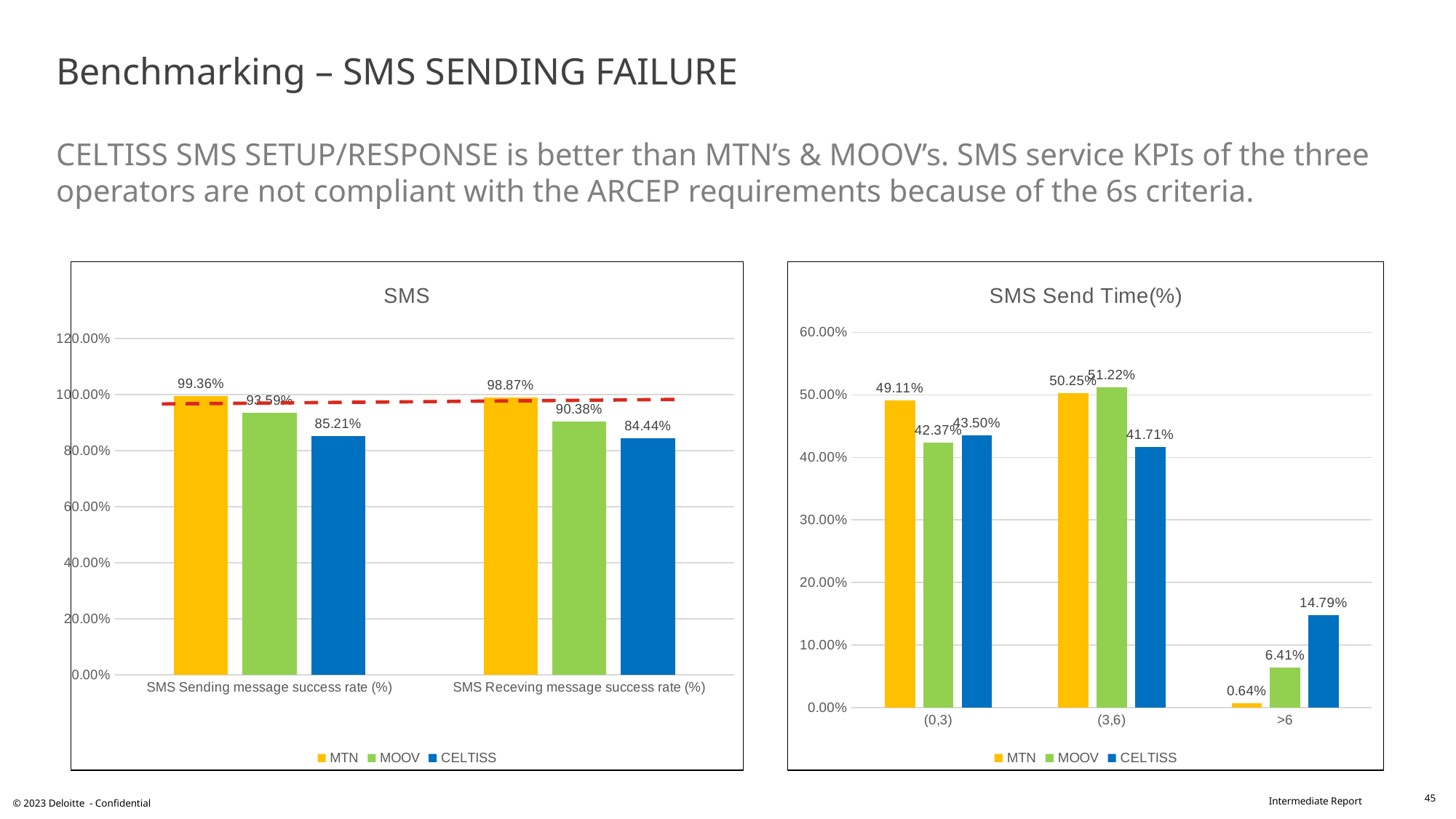
In the "SMS" chart, which operator has the lowest SMS Sending message success rate (%)? CELTISS What kind of chart is the "SMS Send Time(%)" chart? Bar chart In the "SMS Send Time(%)" chart, how many categories are shown on the x axis? 3 In the "SMS Send Time(%)" chart, which is larger in the (0,3) category: MTN or MOOV? MTN In the "SMS Send Time(%)" chart, which operator has the highest value in the >6 category? CELTISS In the "SMS" chart, what is the difference between MTN and MOOV for SMS Receving message success rate (%)? 8.49% In the "SMS" chart, what is the value for CELTISS for SMS Receving message success rate (%)? 84.44% In the "SMS" chart, how many series does the legend list? 3 In the "SMS Send Time(%)" chart, what is the value for CELTISS in the >6 category? 14.79% In the "SMS Send Time(%)" chart, what is the difference between CELTISS and MTN in the >6 category? 14.15% In the "SMS Send Time(%)" chart, what is the value for MOOV in the (3,6) category? 51.22% In the "SMS" chart, what is the value for MTN for SMS Sending message success rate (%)? 99.36%